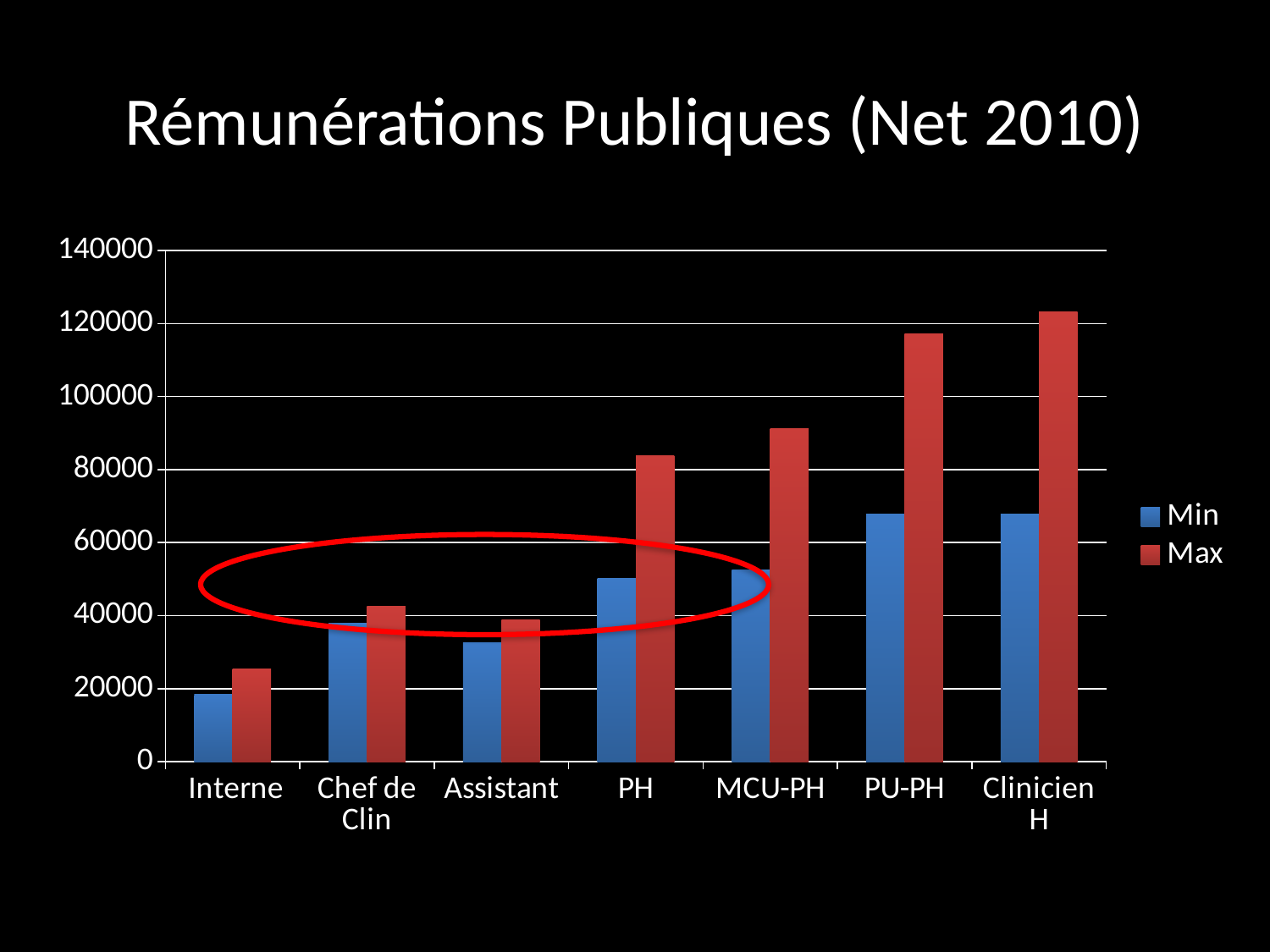
Which category has the highest Max value? Clinicien H Is the Max value for MCU-PH greater or less than 100000? less What is the title of the chart? Rémunérations Publiques (Net 2010) Is the Max value for PU-PH greater or less than 100000? greater What kind of chart is shown on the slide? bar chart Which category has the lowest Max value? Interne Is the Min value for PH greater or less than 40000? greater How many series does the legend list? 2 How many categories are shown on the x axis? 7 Which category has the lowest Min value? Interne Which is larger, the Min value for Chef de Clin or the Min value for Assistant? Chef de Clin